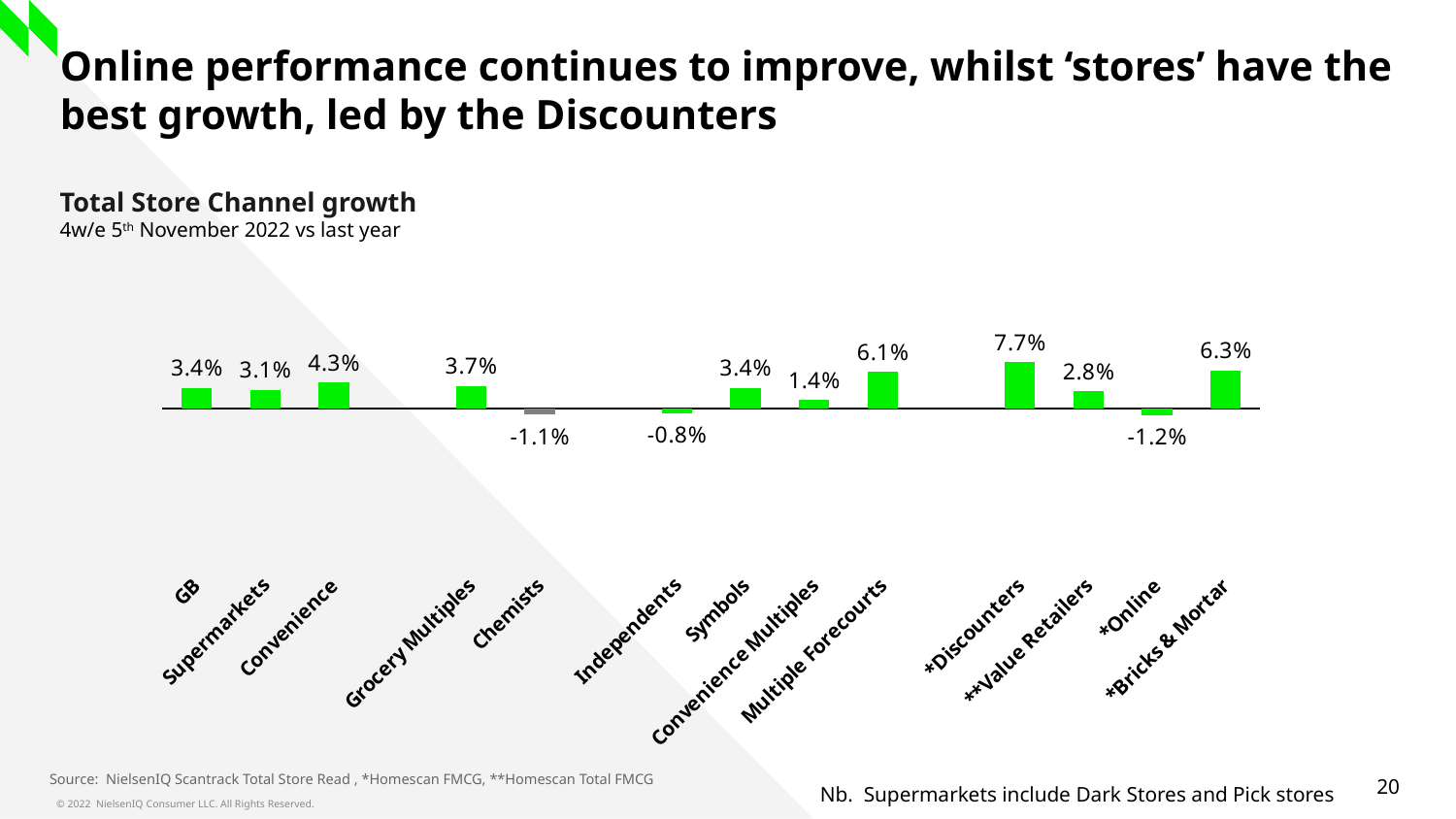
What kind of chart is shown on the slide? Bar chart Which has higher growth, Bricks & Mortar or Multiple Forecourts? Bricks & Mortar What is the growth value for Chemists? -1.1% What is the title of the chart? Total Store Channel growth How many channels are shown in the chart? 13 What is the growth value for Discounters? 7.7% What is the growth value for Multiple Forecourts? 6.1% What is the difference between the growth for Discounters and Value Retailers? 4.9% Which channel has the highest growth? Discounters What is the growth value for GB? 3.4% What is the growth value for Online? -1.2% Which channel has the lowest growth? Online